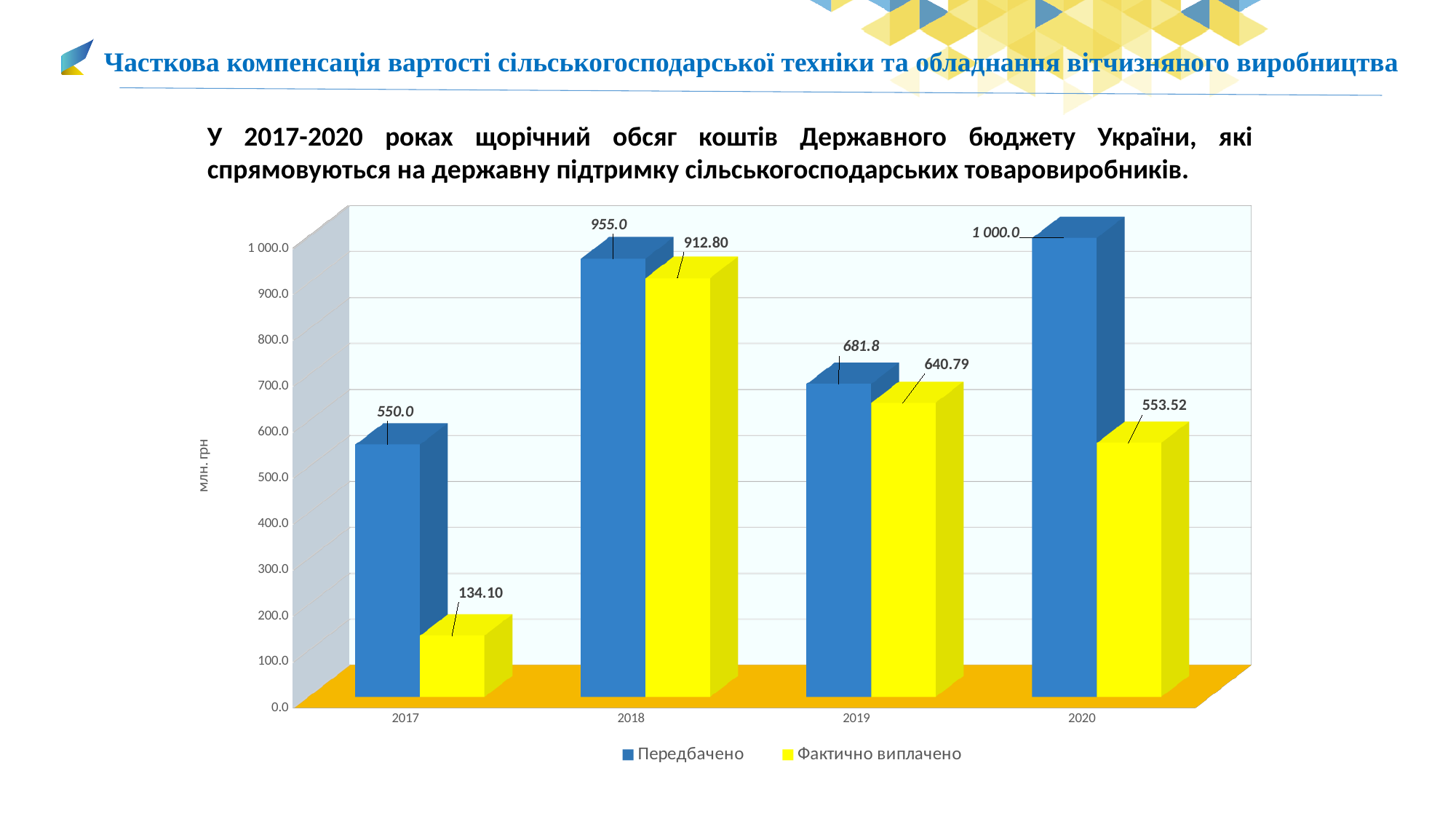
Which is larger in 2018: Передбачено or Фактично виплачено? Передбачено What unit is shown on the vertical axis label? млн. грн What is the value of Фактично виплачено for 2017? 134.10 How many years are shown on the x axis? 4 How many series does the legend list? 2 In which year is Передбачено the highest? 2020 What is the value of Передбачено for 2019? 681.8 In which year is Фактично виплачено the lowest? 2017 What is the value of Фактично виплачено for 2020? 553.52 What is the difference between Передбачено and Фактично виплачено in 2020? 446.48 What kind of chart is shown on the slide? Bar chart What is the value of Передбачено for 2018? 955.0